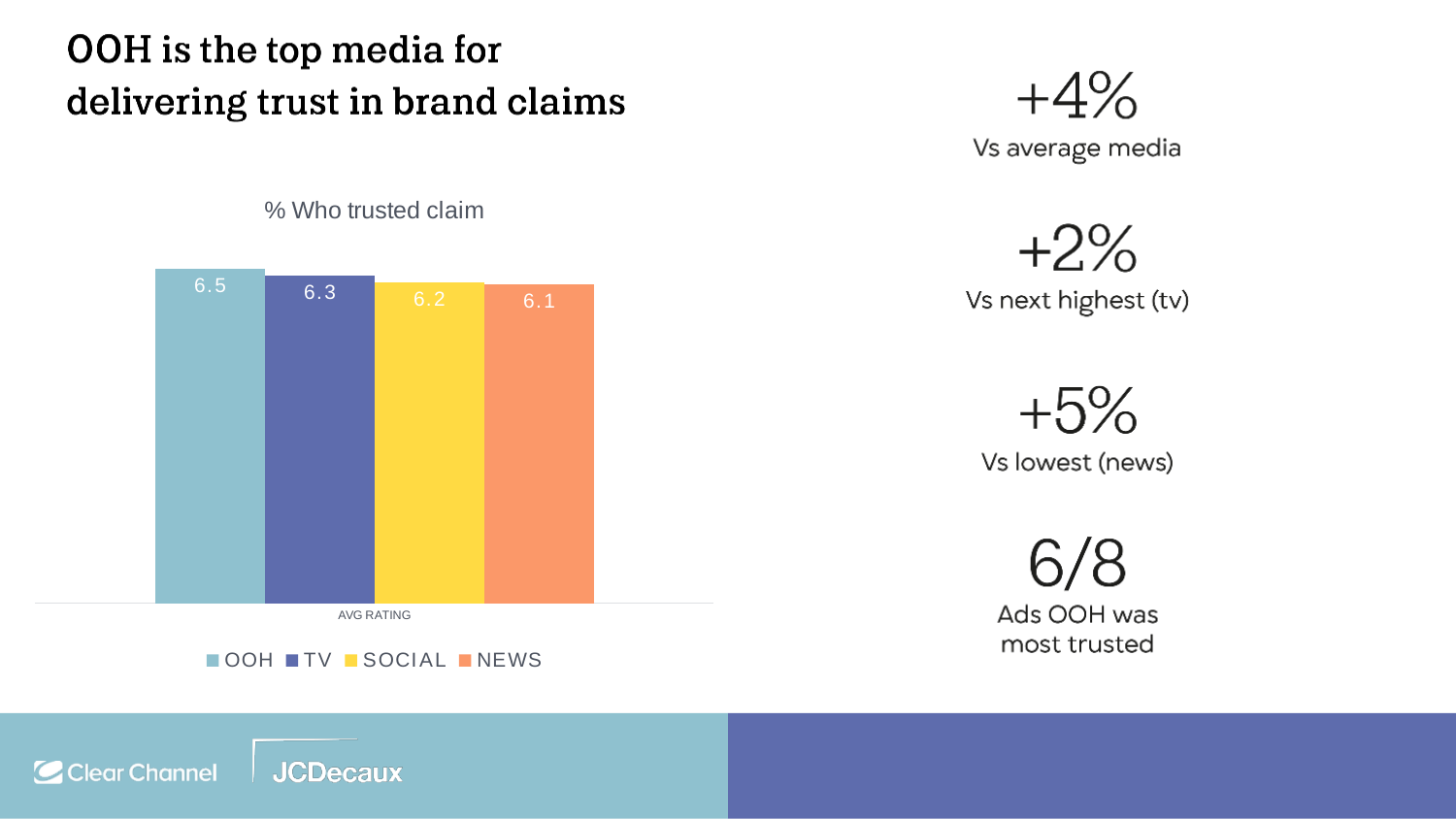
Which media has the lowest value in the chart? NEWS What is the difference between the OOH value and the TV value? 0.2 What kind of chart is shown on the slide? Bar chart What is the value for TV in the chart? 6.3 Which has a larger value, TV or SOCIAL? TV What is the value for SOCIAL in the chart? 6.2 What is the value for NEWS in the chart? 6.1 How many series does the legend list? 4 What is the value for OOH in the '% Who trusted claim' chart? 6.5 What is the title of the chart? % Who trusted claim What is the difference between the OOH value and the NEWS value? 0.4 Which media has the highest value in the chart? OOH